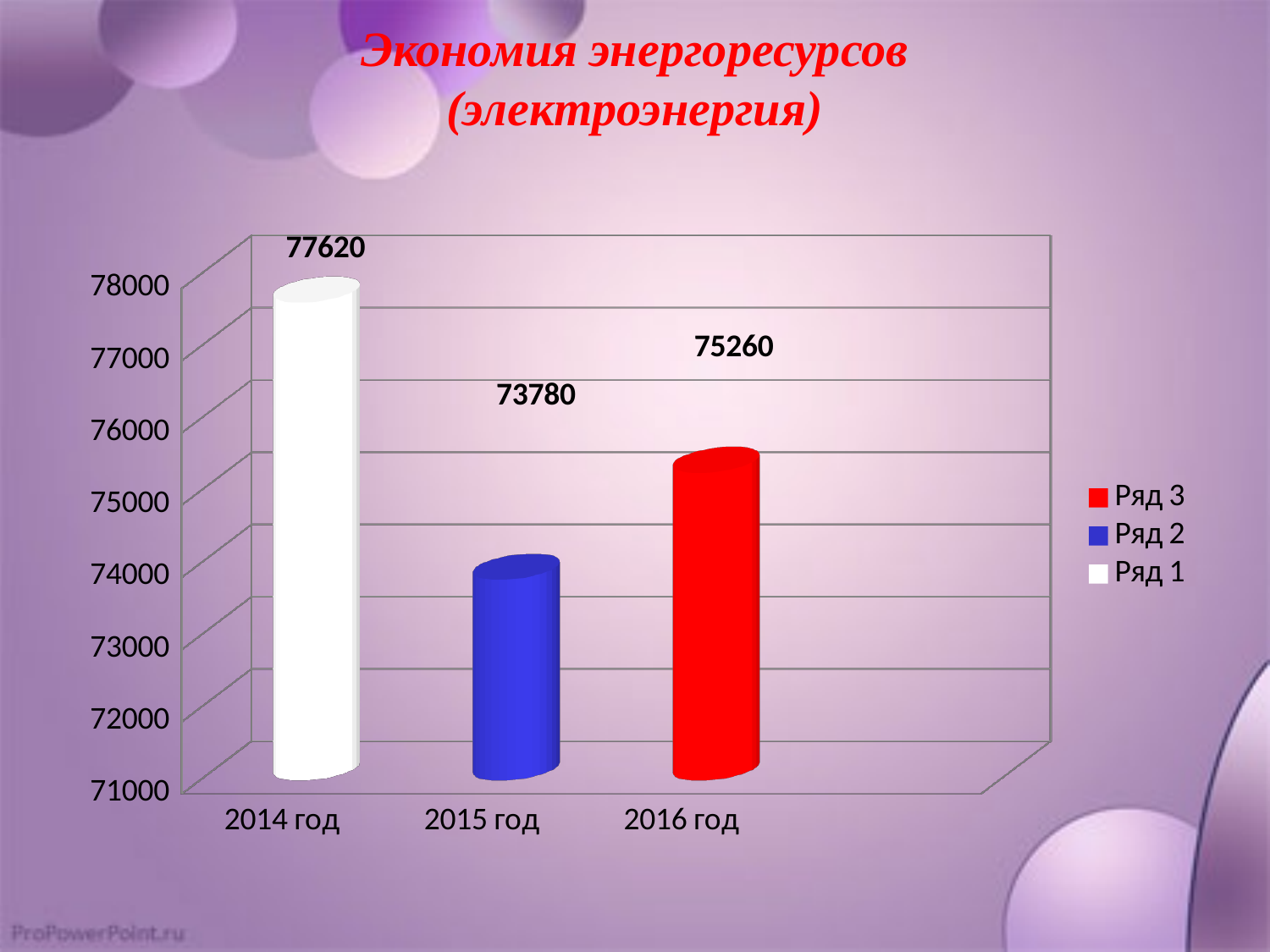
What is the value for 2014 год? 77620 What is the value for 2016 год? 75260 Which year has the lowest value? 2015 год Which year has the highest value? 2014 год What is the difference between the values for 2016 год and 2015 год? 1480 How many years are shown on the x axis? 3 What is the value for 2015 год? 73780 How many series does the legend list? 3 What kind of chart is shown on the slide? bar chart What is the difference between the values for 2014 год and 2015 год? 3840 Is the value for 2016 год greater or less than 76000? less Which is larger, the value for 2016 год or the value for 2015 год? 2016 год